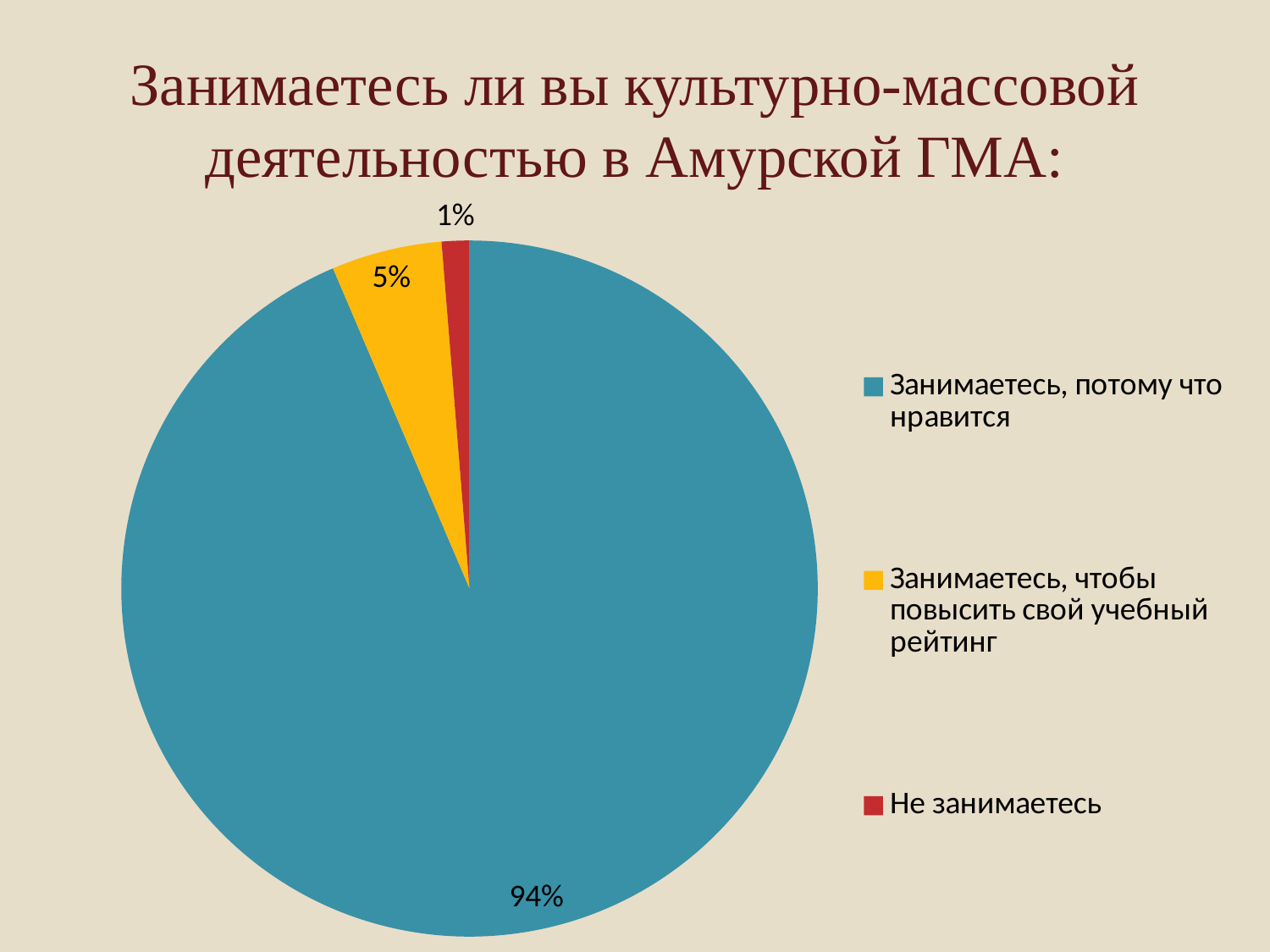
How many categories does the pie chart have? 3 What share of the pie is labelled "Занимаетесь, чтобы повысить свой учебный рейтинг"? 5% What is the title of the slide containing the chart? Занимаетесь ли вы культурно-массовой деятельностью в Амурской ГМА: What share of the pie is labelled "Не занимаетесь"? 1% Which category has the smallest slice of the pie? Не занимаетесь What colour is the slice for "Не занимаетесь"? red What is the difference in percentage points between "Занимаетесь, потому что нравится" and "Занимаетесь, чтобы повысить свой учебный рейтинг"? 89% What is the difference in percentage points between "Занимаетесь, чтобы повысить свой учебный рейтинг" and "Не занимаетесь"? 4% Which category has the largest slice of the pie? Занимаетесь, потому что нравится What kind of chart is shown on the slide? pie chart Which is larger: the slice for "Занимаетесь, чтобы повысить свой учебный рейтинг" or the slice for "Не занимаетесь"? Занимаетесь, чтобы повысить свой учебный рейтинг What share of the pie is labelled "Занимаетесь, потому что нравится"? 94%